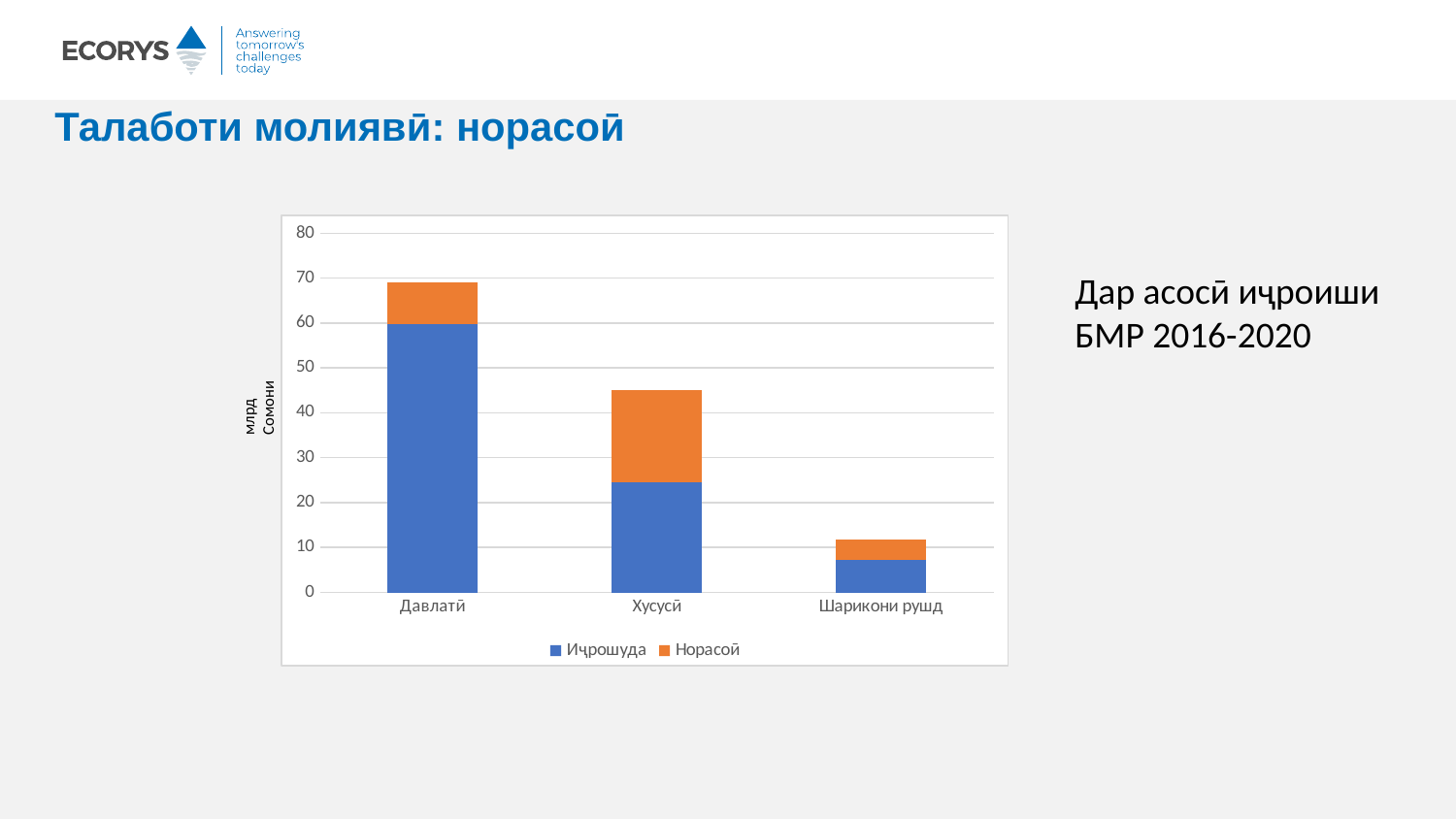
Is the Иҷрошуда value for Хусусӣ greater or less than 30? less What kind of chart is shown on the slide? Stacked bar chart Is the total stacked bar for Шарикони рушд greater or less than 20? less Which category has the tallest stacked bar in the chart? Давлатӣ Which has a larger Норасой segment, Давлатӣ or Хусусӣ? Хусусӣ How many categories are shown on the x axis of the chart? 3 Is the Иҷрошуда value for Давлатӣ greater or less than 50? greater What is the label on the vertical axis of the chart? млрд Сомони How many series does the chart legend list? 2 Which category has the shortest stacked bar in the chart? Шарикони рушд Which has a larger Иҷрошуда value, Давлатӣ or Хусусӣ? Давлатӣ